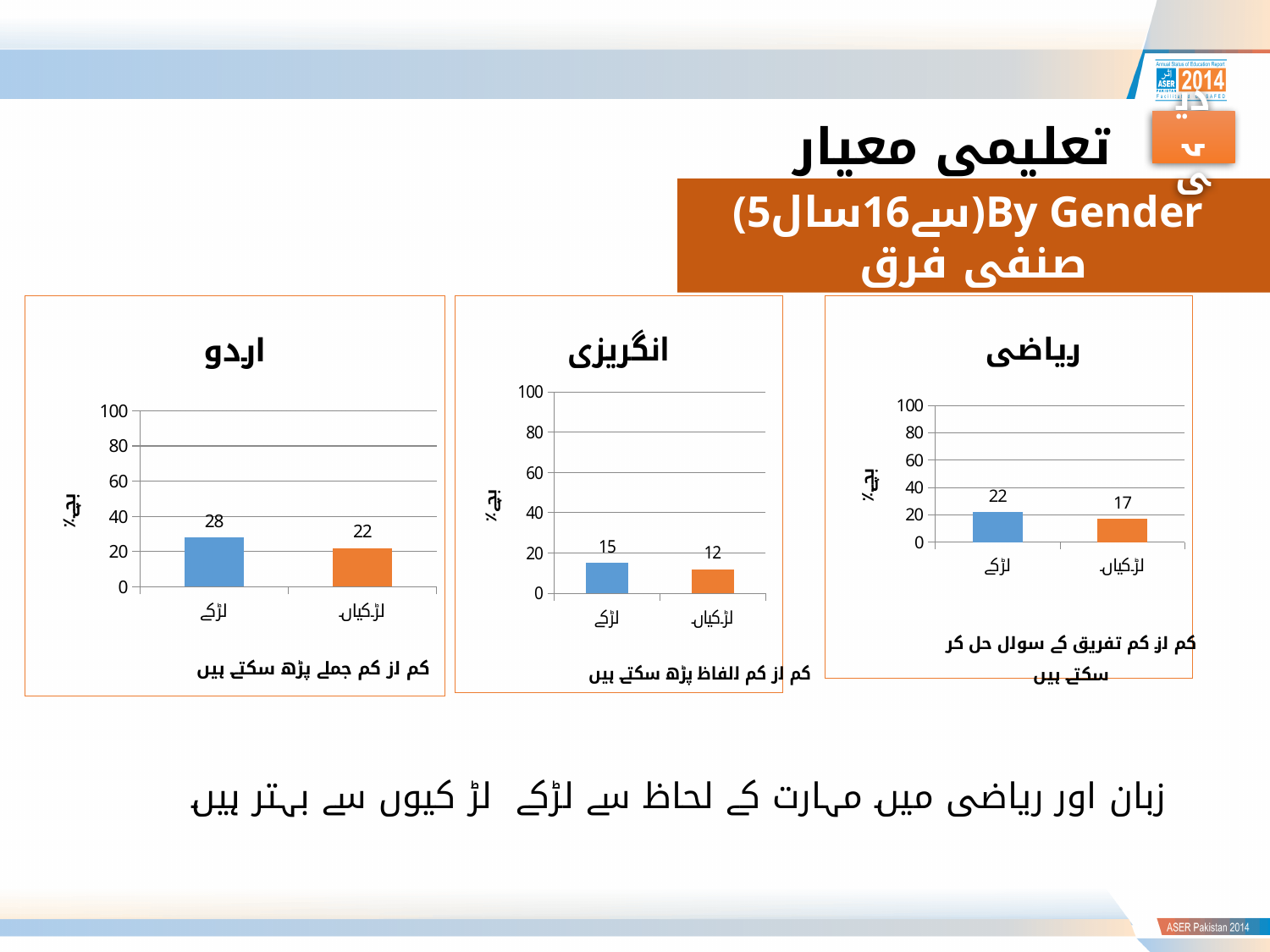
In the اردو (Urdu) chart on the left, what is the difference between the values for لڑکے (boys) and لڑکیاں (girls)? 6 In the انگریزی (English) chart in the middle, what is the value for لڑکیاں (girls)? 12 In the اردو (Urdu) chart on the left, what is the value for لڑکیاں (girls)? 22 What type of chart is the اردو (Urdu) chart on the left? bar chart In the ریاضی (Math) chart on the right, what is the value for لڑکے (boys)? 22 How many categories are shown in the ریاضی (Math) chart on the right? 2 In the ریاضی (Math) chart on the right, what is the value for لڑکیاں (girls)? 17 In the انگریزی (English) chart in the middle, which category has the lowest value? لڑکیاں (girls) In the انگریزی (English) chart in the middle, is the value for لڑکے (boys) greater or less than 20? less In the اردو (Urdu) chart on the left, what is the value for لڑکے (boys)? 28 In the انگریزی (English) chart in the middle, what is the value for لڑکے (boys)? 15 In the ریاضی (Math) chart on the right, which category has the higher value, لڑکے (boys) or لڑکیاں (girls)? لڑکے (boys)